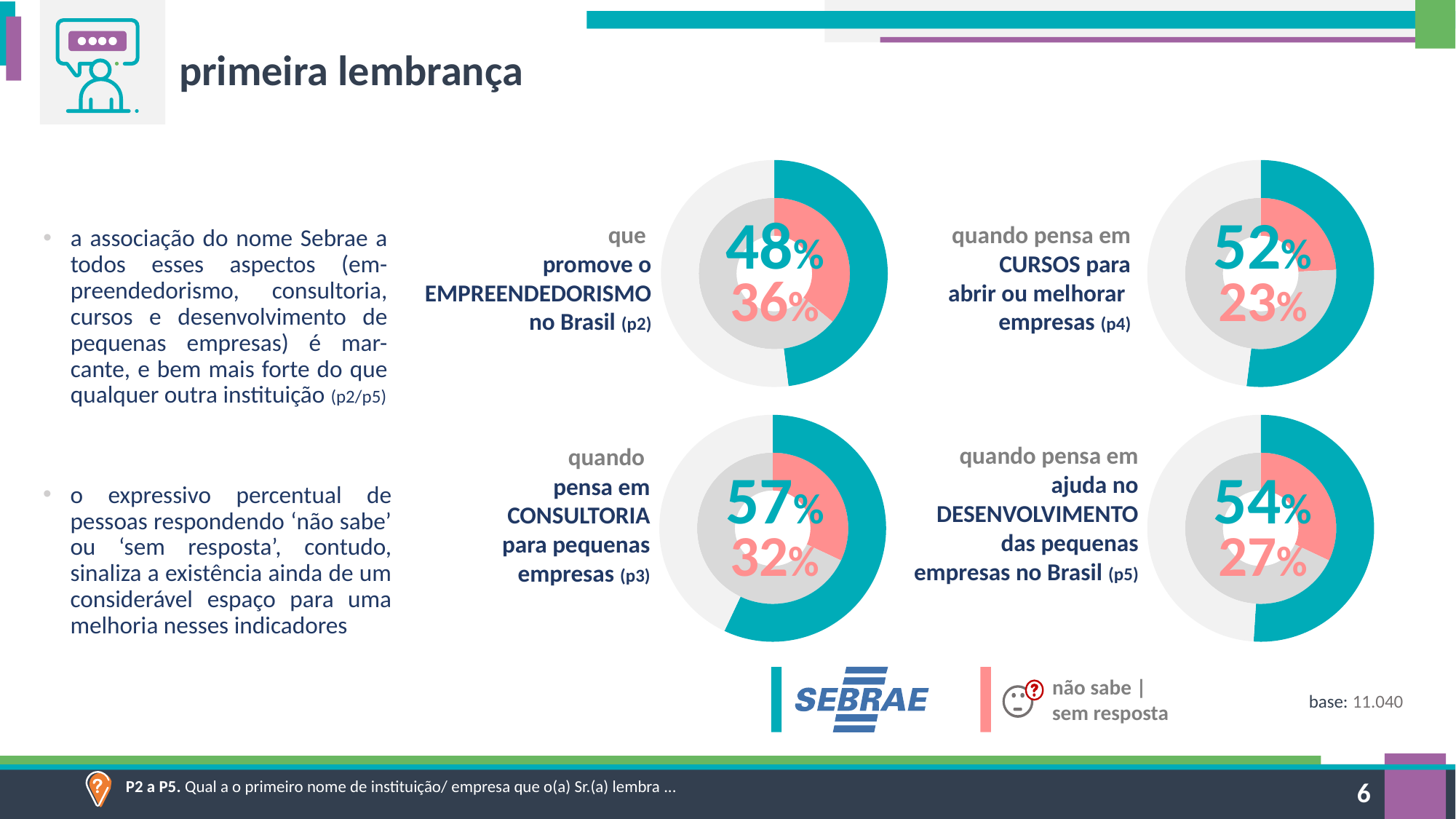
What is the base (number of respondents) shown on the slide? 11.040 How many categories does the legend at the bottom of the slide list? 2 In the donut chart for 'quando pensa em CONSULTORIA para pequenas empresas (p3)', what percentage is shown for SEBRAE (teal)? 57% Across the four donut charts, which topic has the lowest 'não sabe | sem resposta' (pink) percentage? CURSOS para abrir ou melhorar empresas (p4) What type of chart is used to show the percentages on the slide? Donut (pie) chart In the donut chart for 'que promove o EMPREENDEDORISMO no Brasil (p2)', what is the difference between the SEBRAE percentage and the 'não sabe | sem resposta' percentage? 12% In the donut chart for 'quando pensa em CURSOS para abrir ou melhorar empresas (p4)', what percentage is shown for 'não sabe | sem resposta' (pink)? 23% In the donut chart for 'quando pensa em ajuda no DESENVOLVIMENTO das pequenas empresas no Brasil (p5)', what percentage is shown for 'não sabe | sem resposta' (pink)? 27% Which is larger: the SEBRAE percentage for CURSOS (p4) or the SEBRAE percentage for DESENVOLVIMENTO (p5)? DESENVOLVIMENTO (p5) In the donut chart for 'que promove o EMPREENDEDORISMO no Brasil (p2)', what percentage is shown for SEBRAE (teal)? 48% How many donut charts are shown on the slide? 4 Across the four donut charts, which topic has the highest SEBRAE (teal) percentage? CONSULTORIA para pequenas empresas (p3)